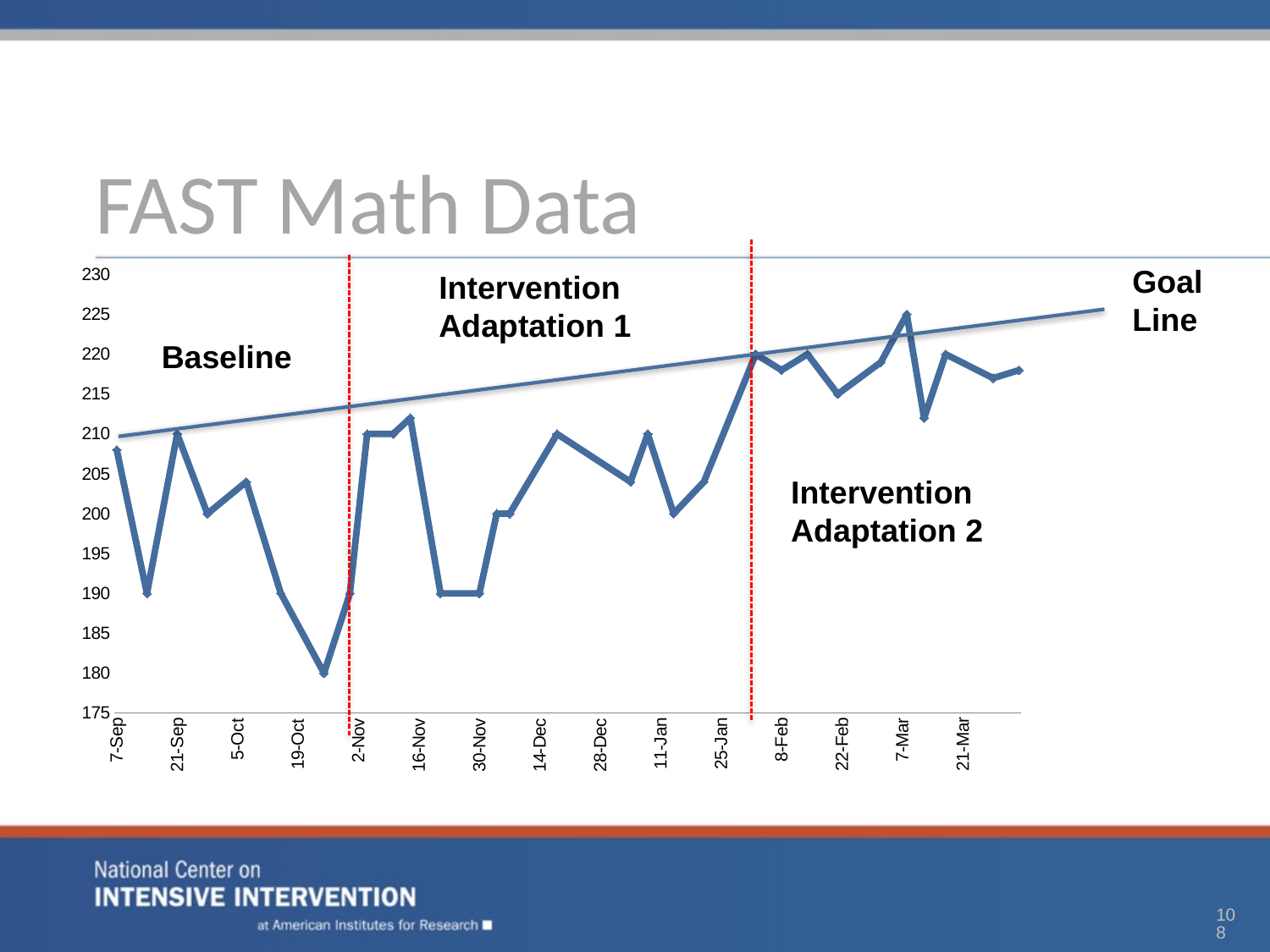
On which date does the student data line reach its highest value? 7-Mar Is the value for 7-Sep greater or less than 210? less Is the value for 7-Mar greater or less than 220? greater Which is larger, the value for 7-Mar or the value for 7-Sep? 7-Mar What is the label of the straight rising line on the chart? Goal Line What type of chart is shown on the slide? line chart What is the title of the chart? FAST Math Data Is the value for 8-Feb greater or less than 215? greater In which phase does the lowest value of the student data line occur? Baseline Does the Goal Line rise or fall from 7-Sep to 21-Mar? rise How many phases are labelled on the chart (Baseline, Intervention Adaptation 1, Intervention Adaptation 2)? 3